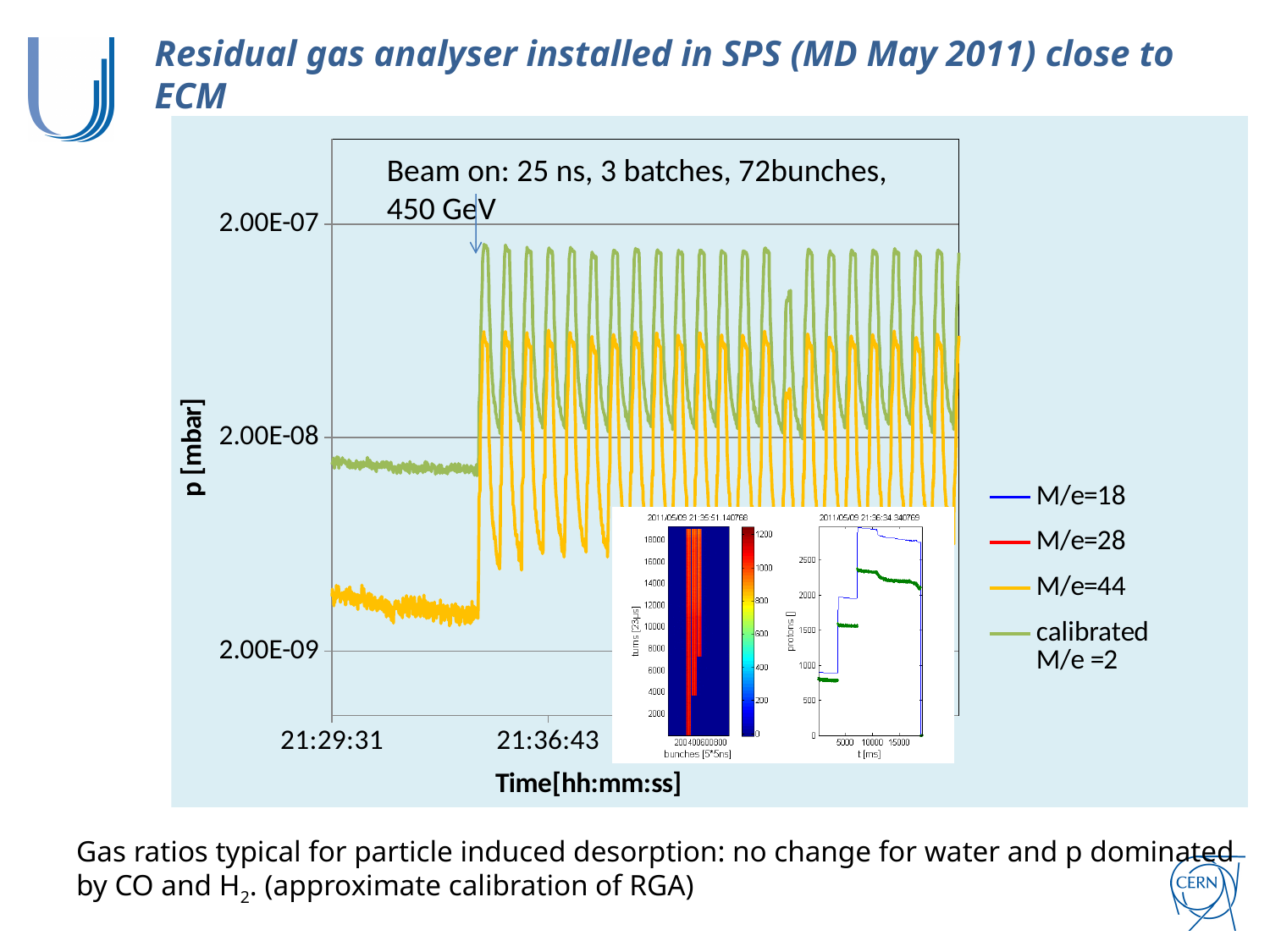
After the beam is turned on, are the peak values of the M/e=44 series greater or less than 2.00E-08? greater What kind of chart is shown on the slide? line chart Does the pressure rise or fall when the beam is turned on? rise Before the beam is turned on, is the value of the calibrated M/e =2 series greater or less than 2.00E-08? less After the beam is turned on, are the peak values of the calibrated M/e =2 series greater or less than 2.00E-07? less What is the label of the y-axis of the chart? p [mbar] According to the annotation on the chart, at what beam energy was the beam on? 450 GeV Before the beam is turned on, which series shows the higher pressure: calibrated M/e =2 or M/e=44? calibrated M/e =2 How many series does the chart legend list? 4 Which series in the legend is drawn in blue? M/e=18